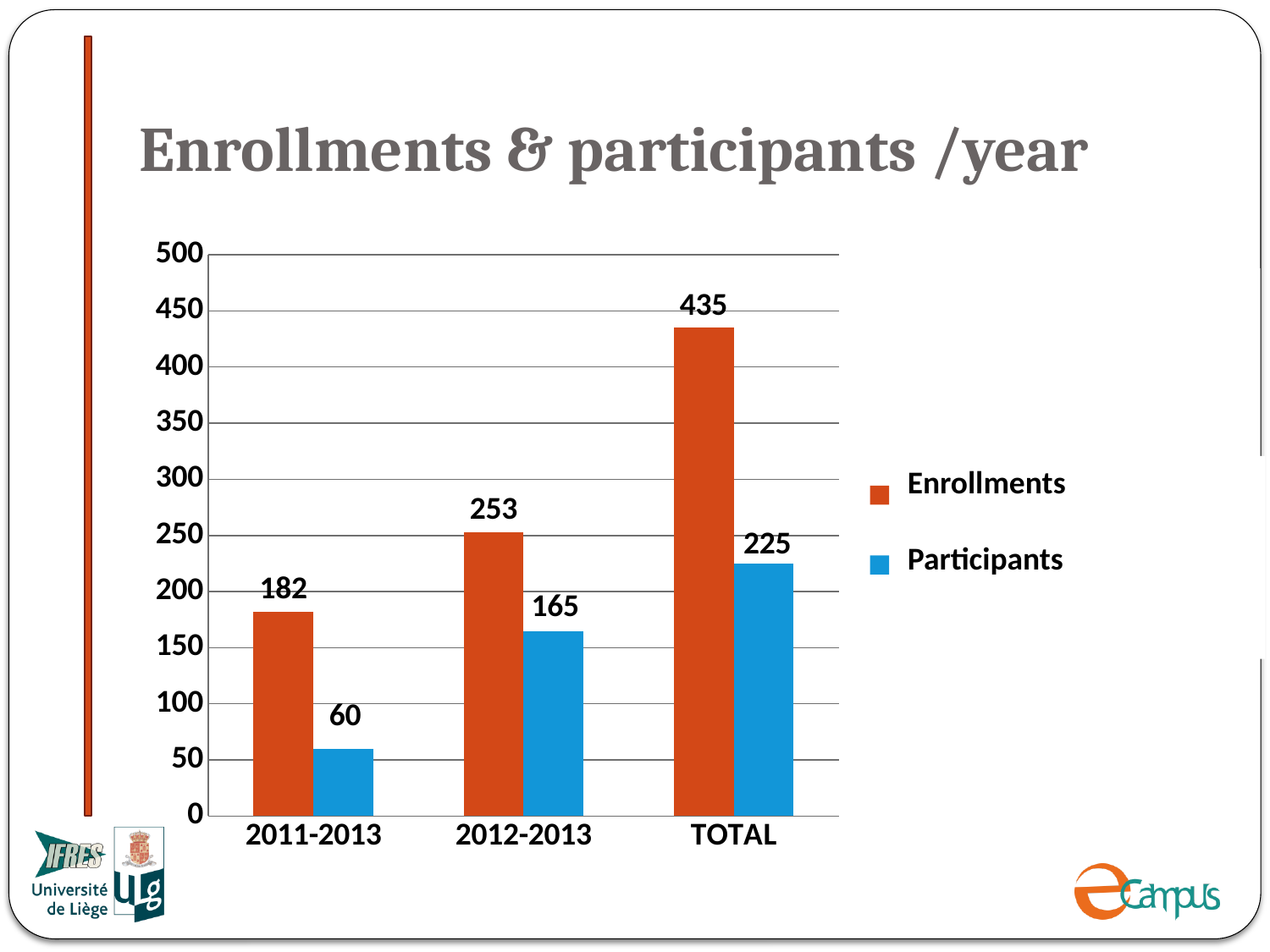
How many series does the legend list? 2 What kind of chart is shown on the slide? Bar chart What is the Enrollments value for 2011-2013? 182 Which category has the lowest Enrollments value? 2011-2013 What is the Participants value for 2011-2013? 60 What is the Enrollments value for TOTAL? 435 Which category has the highest Participants value? TOTAL How many categories are shown on the x axis? 3 Which is larger for 2011-2013: Enrollments or Participants? Enrollments What is the title of the chart? Enrollments & participants /year What is the difference between Enrollments and Participants for 2012-2013? 88 What is the Participants value for 2012-2013? 165